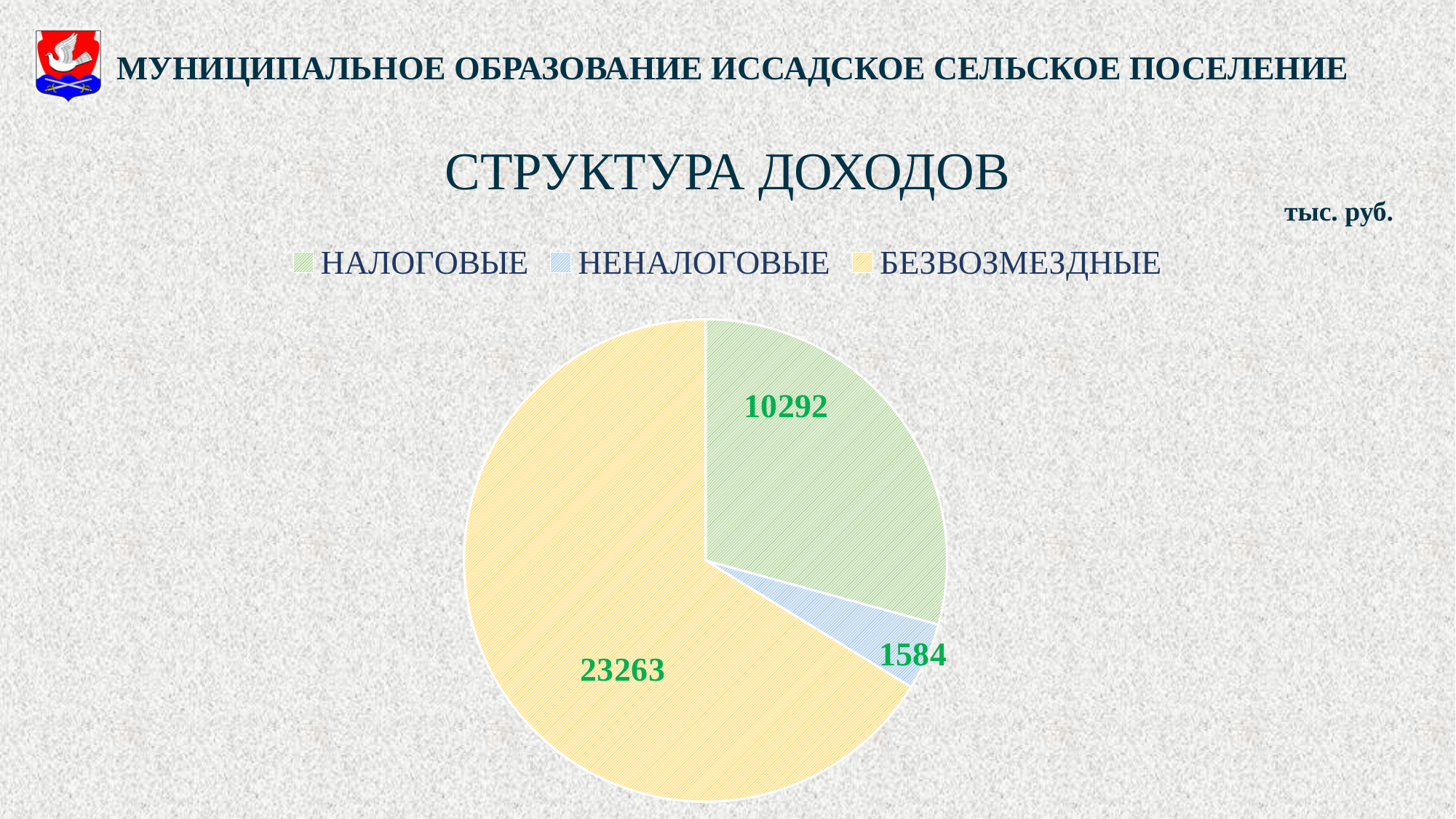
What is the value for НЕНАЛОГОВЫЕ in the pie chart? 1584 What is the difference between the values for НАЛОГОВЫЕ and НЕНАЛОГОВЫЕ? 8708 What is the value for НАЛОГОВЫЕ in the pie chart? 10292 What is the difference between the values for БЕЗВОЗМЕЗДНЫЕ and НАЛОГОВЫЕ? 12971 Which category has the largest slice of the pie chart? БЕЗВОЗМЕЗДНЫЕ How many categories are shown in the pie chart? 3 What is the title of the chart? СТРУКТУРА ДОХОДОВ Which category has the smallest slice of the pie chart? НЕНАЛОГОВЫЕ What is the value for БЕЗВОЗМЕЗДНЫЕ in the pie chart? 23263 What unit is indicated for the values in the chart? тыс. руб. What kind of chart is shown on the slide? Pie chart Which is larger, the value for НАЛОГОВЫЕ or the value for НЕНАЛОГОВЫЕ? НАЛОГОВЫЕ